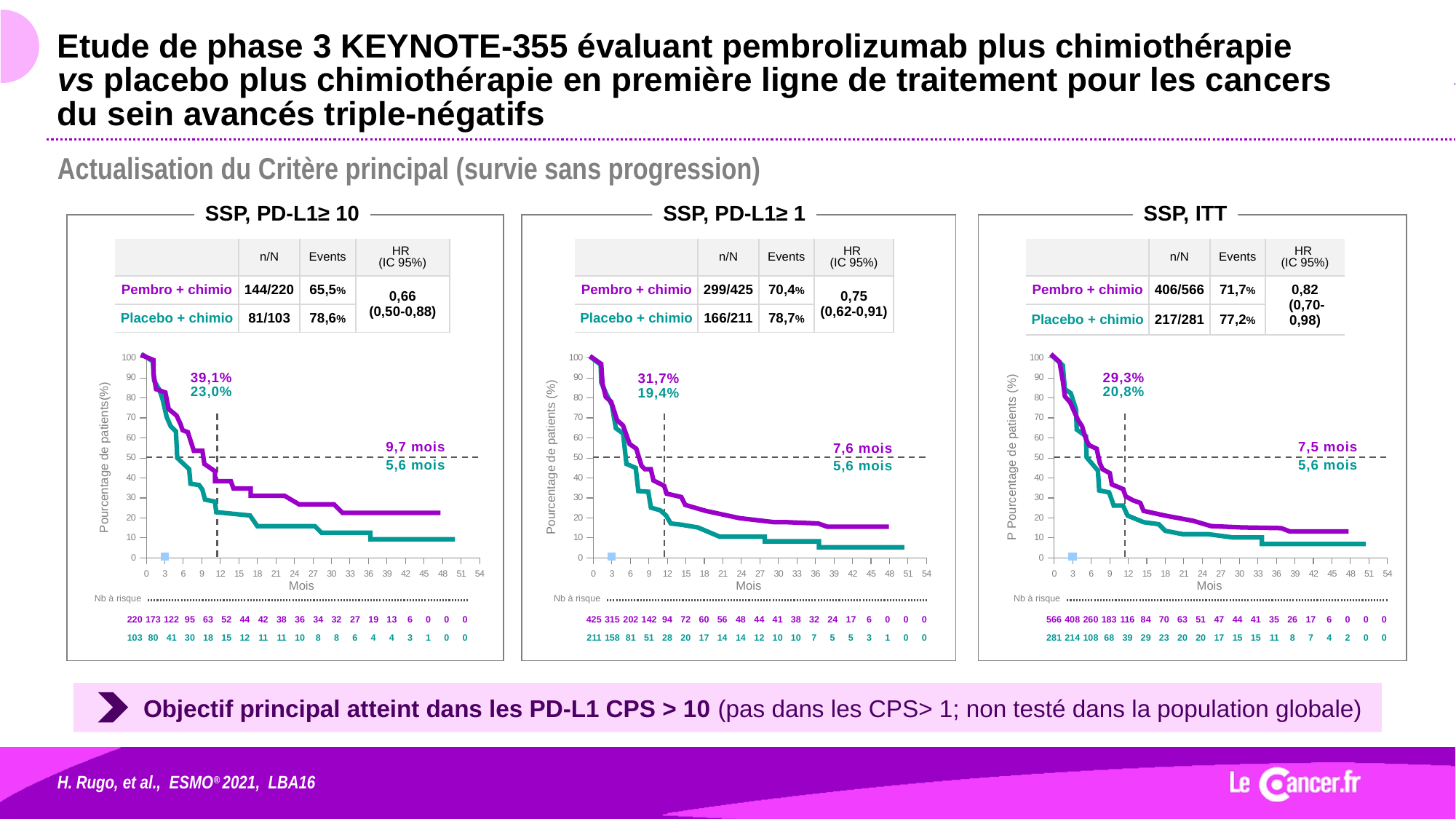
In the 'SSP, PD-L1≥ 10' chart, what is the median progression-free survival shown for Pembro + chimio? 9,7 mois In the 'SSP, PD-L1≥ 1' chart, what is the median progression-free survival shown for Placebo + chimio? 5,6 mois In the 'SSP, PD-L1≥ 1' chart, how many Pembro + chimio patients are at risk at month 0? 425 In the 'SSP, PD-L1≥ 10' chart, how many Placebo + chimio patients are at risk at month 12? 18 In the 'SSP, PD-L1≥ 10' chart, is the Placebo + chimio curve at 24 months greater or less than 30%? less In the 'SSP, ITT' chart, which arm has the higher curve at 12 months? Pembro + chimio In the 'SSP, PD-L1≥ 10' chart, what is the difference between the landmark percentages shown for Pembro + chimio (39,1%) and Placebo + chimio (23,0%)? 16,1 percentage points In the three charts, what colour is the Pembro + chimio curve? Purple In the 'SSP, PD-L1≥ 1' chart, by how many months does the median PFS of Pembro + chimio exceed that of Placebo + chimio? 2,0 mois What kind of chart is used in each of the three panels? Kaplan-Meier survival curve (line chart) In the 'SSP, ITT' chart, what percentage of events is reported for Placebo + chimio? 77,2% In the 'SSP, ITT' chart, what hazard ratio (IC 95%) is given in the table? 0,82 (0,70-0,98)